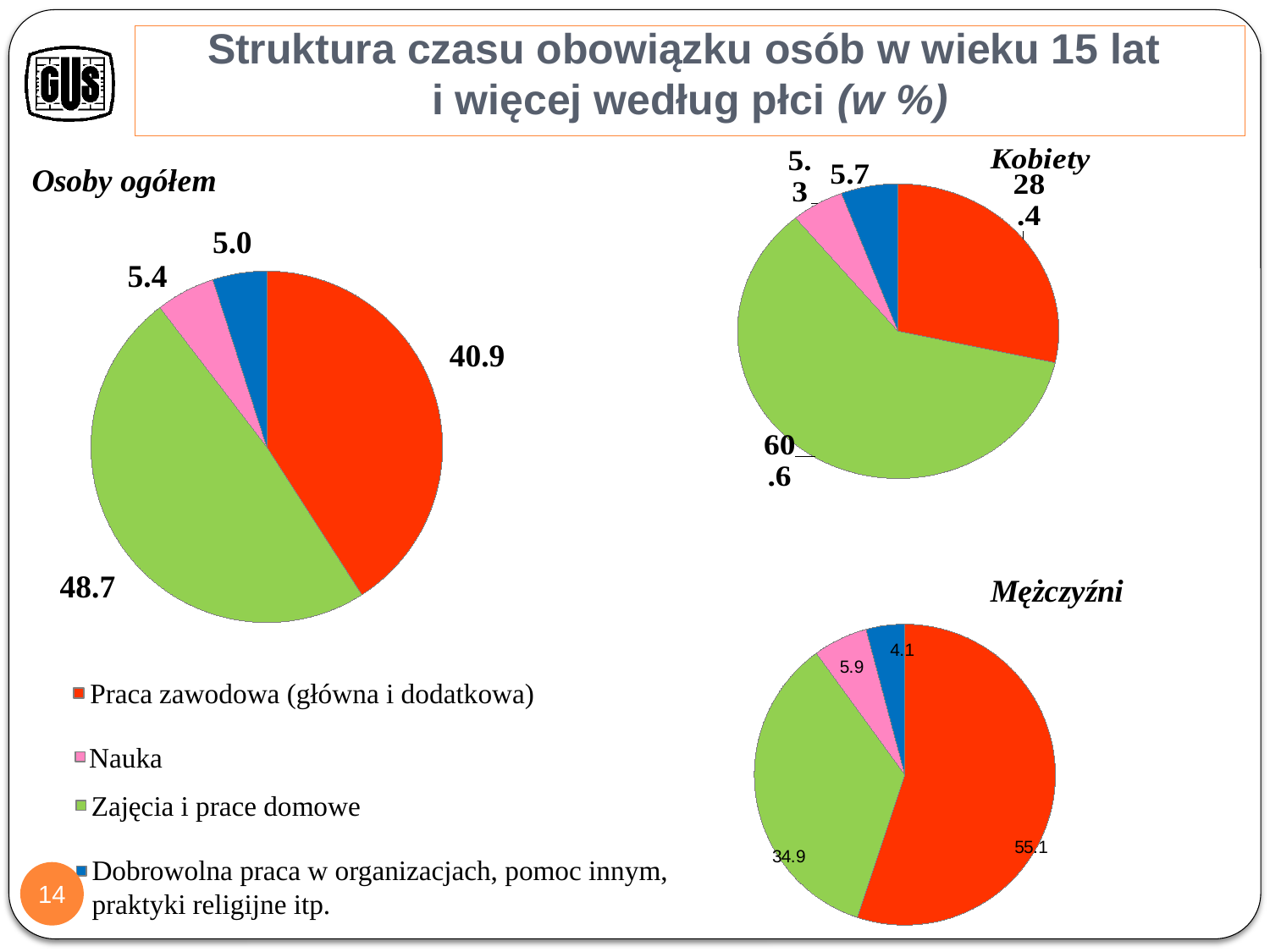
In the 'Mężczyźni' pie chart, which category has the smallest slice? Dobrowolna praca w organizacjach, pomoc innym, praktyki religijne itp. In the 'Kobiety' pie chart, what is the value for 'Zajęcia i prace domowe'? 60.6 How many categories does the legend list? 4 How many pie charts are shown on the slide? 3 In the 'Kobiety' pie chart, which category has the largest slice? Zajęcia i prace domowe In the 'Osoby ogółem' pie chart, what is the value for 'Zajęcia i prace domowe'? 48.7 In the 'Kobiety' pie chart, what is the difference between 'Zajęcia i prace domowe' and 'Praca zawodowa (główna i dodatkowa)'? 32.2 Which is larger: 'Praca zawodowa (główna i dodatkowa)' in the 'Mężczyźni' chart or in the 'Kobiety' chart? Mężczyźni In the 'Osoby ogółem' pie chart, what is the value for 'Praca zawodowa (główna i dodatkowa)'? 40.9 In the 'Mężczyźni' pie chart, what is the value for 'Praca zawodowa (główna i dodatkowa)'? 55.1 In the 'Osoby ogółem' pie chart, what is the difference between 'Zajęcia i prace domowe' and 'Praca zawodowa (główna i dodatkowa)'? 7.8 In the 'Mężczyźni' pie chart, what is the value for 'Nauka'? 5.9